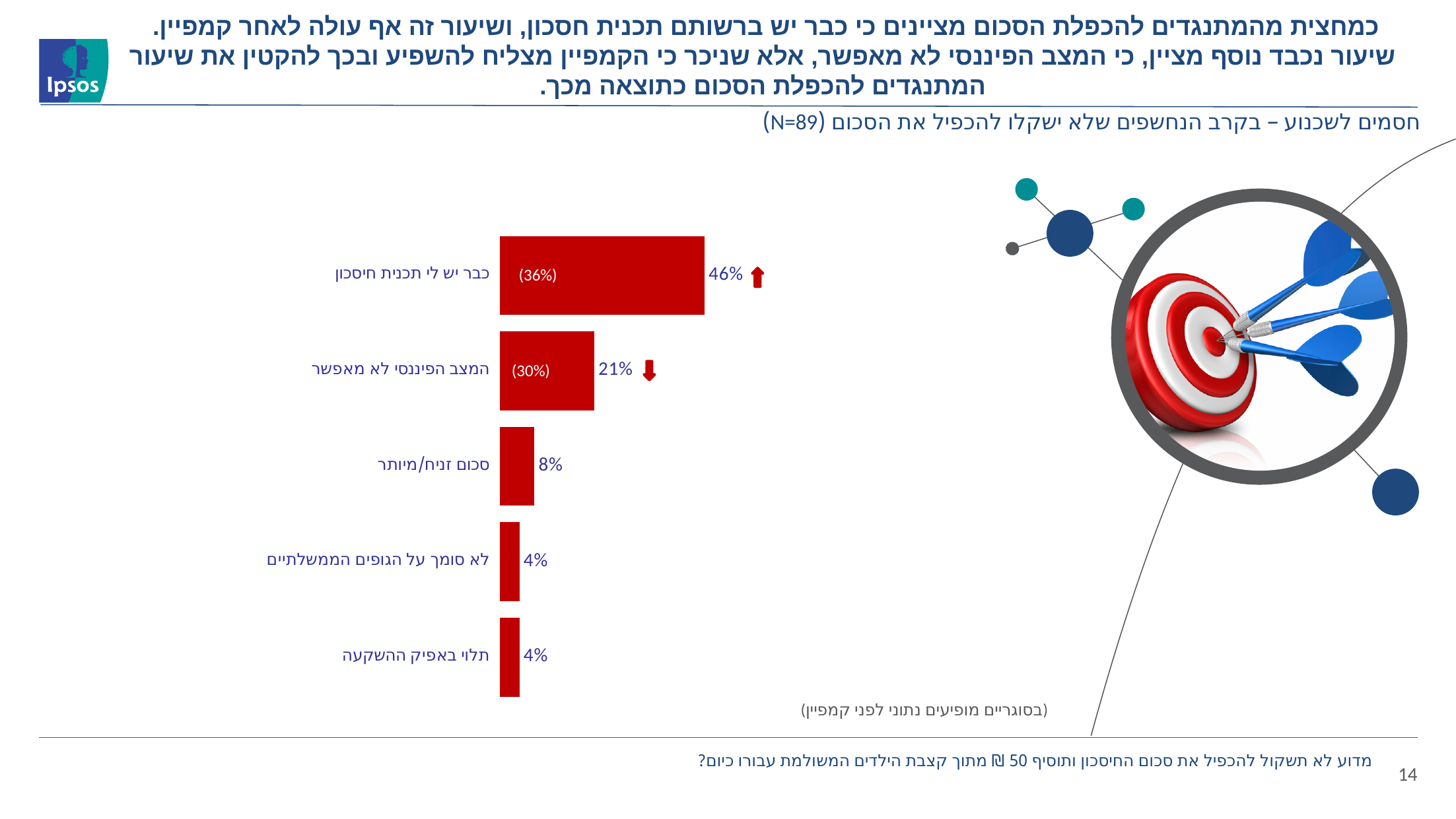
What is the value shown for the category "סכום זניח/מיותר"? 8% What colour are the bars in the chart? Red Which is larger: the value for "המצב הפיננסי לא מאפשר" or the value for "סכום זניח/מיותר"? המצב הפיננסי לא מאפשר What pre-campaign value is shown in parentheses for "כבר יש לי תכנית חיסכון"? (36%) What is the value shown for the category "כבר יש לי תכנית חיסכון"? 46% What is the value shown for the category "לא סומך על הגופים הממשלתיים"? 4% What is the difference between the values for "כבר יש לי תכנית חיסכון" and "המצב הפיננסי לא מאפשר"? 25% Which category has the highest value? כבר יש לי תכנית חיסכון What kind of chart is shown on the slide? Bar chart What is the value shown for the category "המצב הפיננסי לא מאפשר"? 21% How many categories are shown in the chart? 5 What pre-campaign value is shown in parentheses for "המצב הפיננסי לא מאפשר"? (30%)